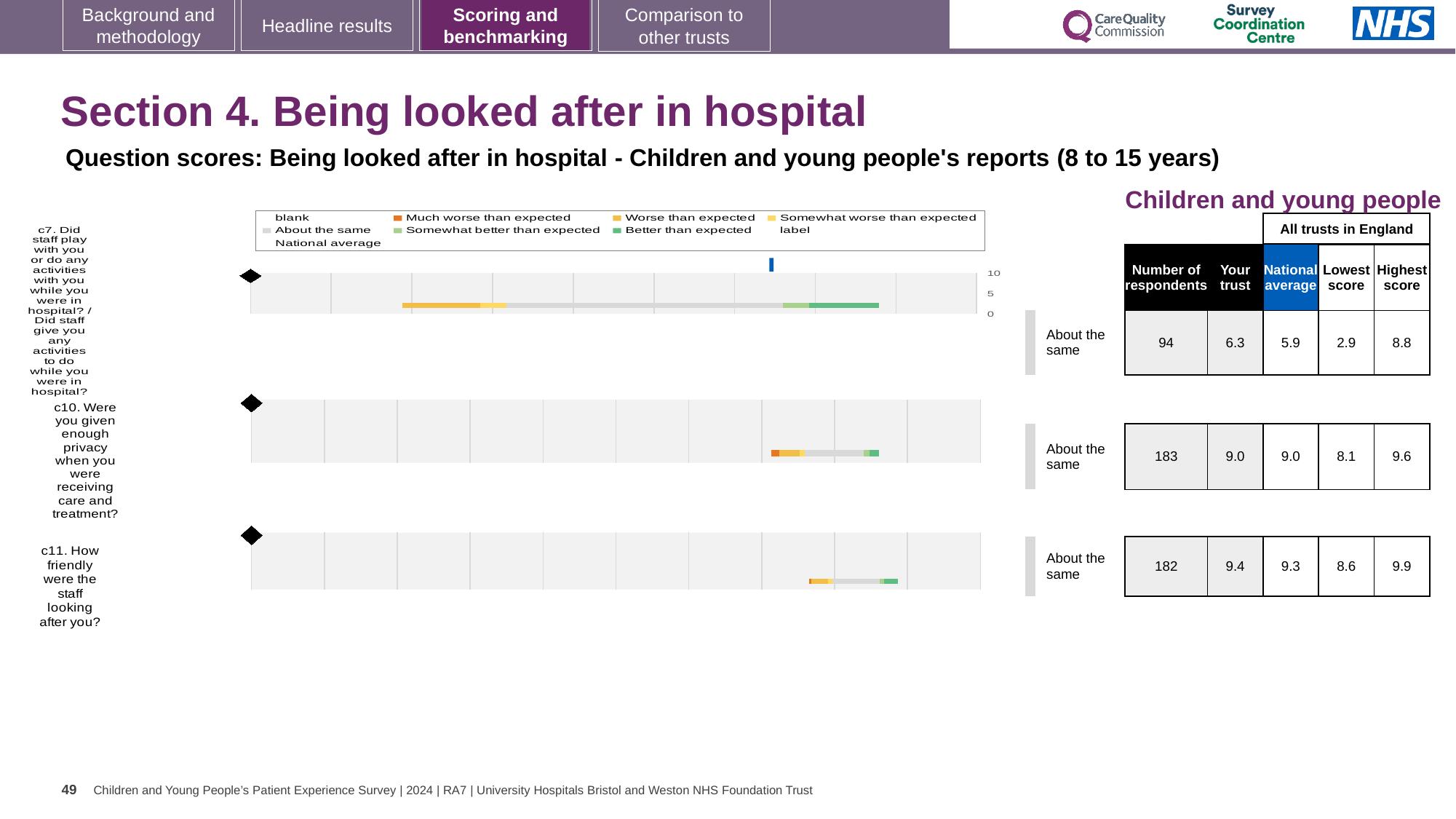
What benchmark category is shown for c10? About the same How many survey questions (bars) are plotted on the slide? 3 How many respondents answered c7 (Did staff play with you or do any activities with you while you were in hospital?)? 94 For c7, which is larger: the 'Your trust' score or the national average? Your trust For c11, how much higher is the 'Your trust' score than the national average? 0.1 What is the 'Your trust' score for c10 (Were you given enough privacy when you were receiving care and treatment?)? 9.0 What kind of chart is used to show the question scores on this slide? Bar chart Which question has the highest 'Your trust' score? c11. How friendly were the staff looking after you? What is the national average score for c11 (How friendly were the staff looking after you?)? 9.3 For c7, what is the difference between the highest score and the lowest score across all trusts in England? 5.9 What is the lowest score across all trusts in England for c11? 8.6 Which question has the lowest 'Your trust' score? c7. Did staff play with you or do any activities with you while you were in hospital?